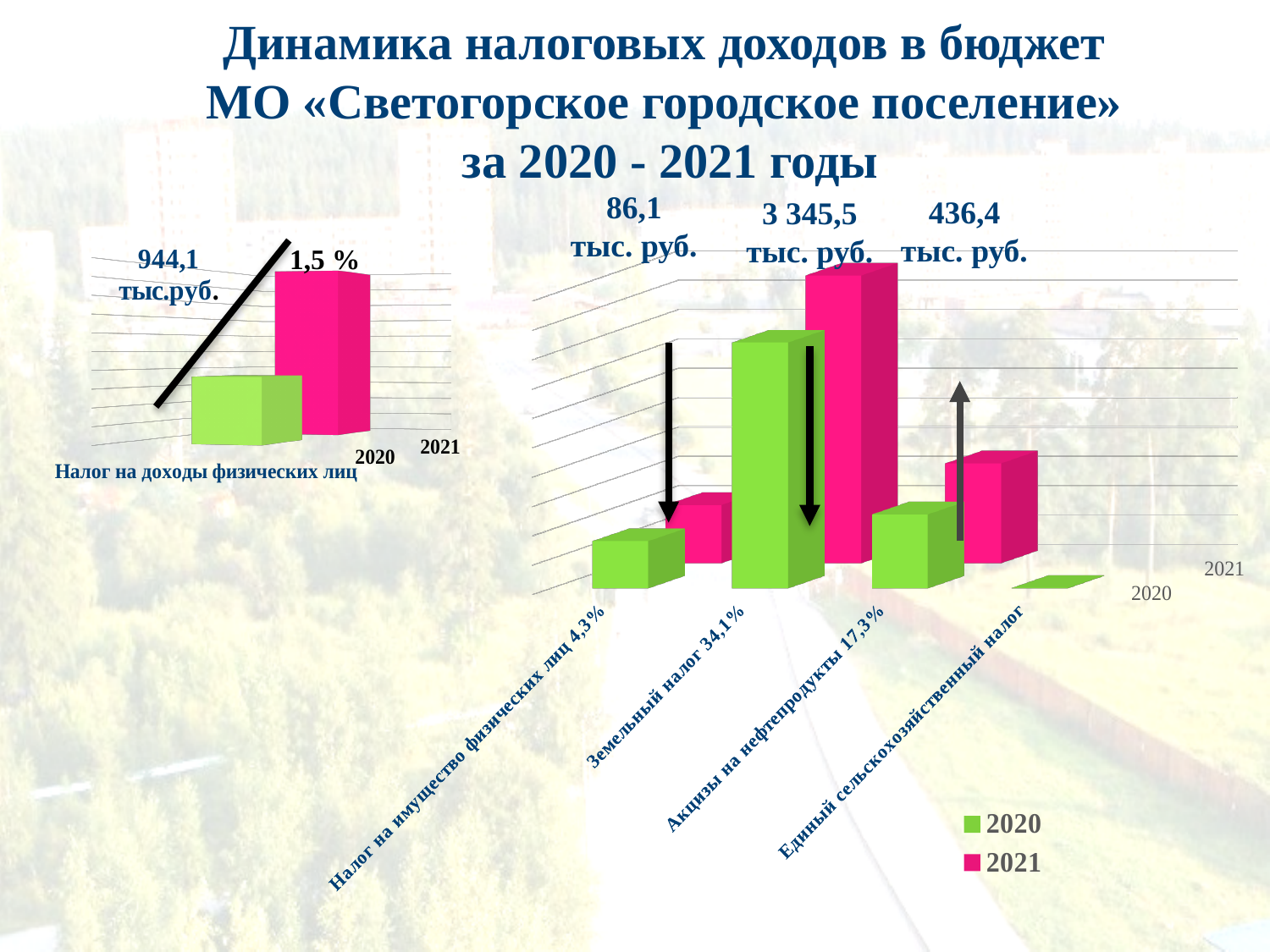
In the left chart «Налог на доходы физических лиц», which year has the taller bar, 2020 or 2021? 2021 In the left chart «Налог на доходы физических лиц», what amount in тыс.руб. is annotated on the chart? 944,1 тыс.руб. What are the two legend entries of the right chart? 2020 and 2021 How many categories are shown on the x axis of the right chart? 4 What kind of chart is the right chart? bar chart What kind of chart is the left chart titled «Налог на доходы физических лиц»? bar chart In the right chart, which colour represents the 2021 series in the legend? pink In the right chart, what percentage is given in the category label for «Земельный налог»? 34,1% How many series does the legend of the right chart list? 2 In the right chart, what percentage is given in the category label for «Налог на имущество физических лиц»? 4,3% In the left chart «Налог на доходы физических лиц», what percentage is annotated next to the 2021 bar? 1,5 % In the right chart, what percentage is given in the category label for «Акцизы на нефтепродукты»? 17,3%